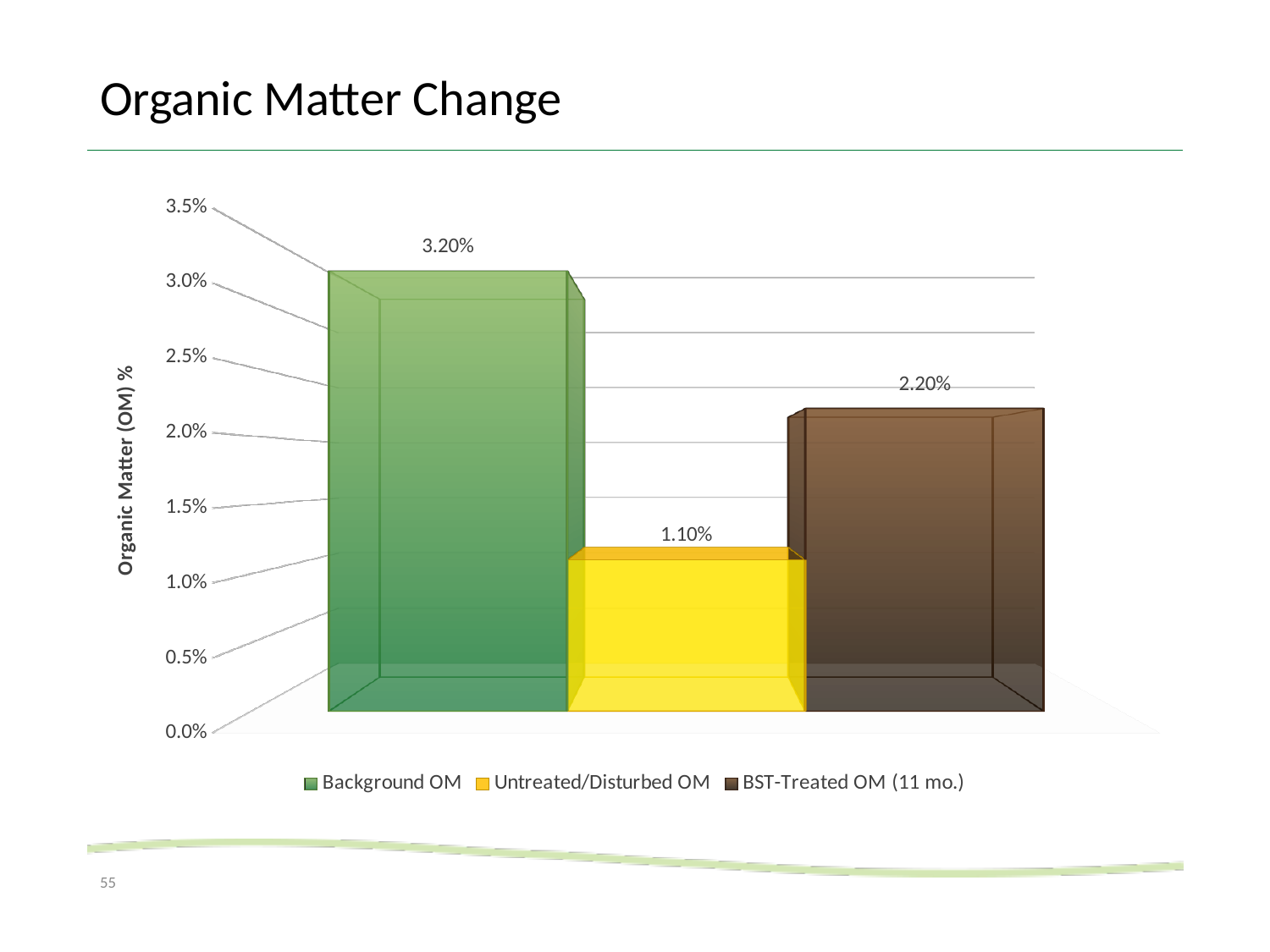
Which series has the highest organic matter value? Background OM How many series does the legend list? 3 What is the value for BST-Treated OM (11 mo.)? 2.20% Which is larger, the value for BST-Treated OM (11 mo.) or the value for Untreated/Disturbed OM? BST-Treated OM (11 mo.) What kind of chart is shown on the slide? Bar chart What is the value for Untreated/Disturbed OM? 1.10% What is the title of the chart? Organic Matter Change Is the value for Background OM greater or less than 3.0%? greater What is the difference between the BST-Treated OM (11 mo.) value and the Untreated/Disturbed OM value? 1.10% Which series has the lowest organic matter value? Untreated/Disturbed OM What is the value for Background OM? 3.20% What is the difference between the Background OM value and the Untreated/Disturbed OM value? 2.10%